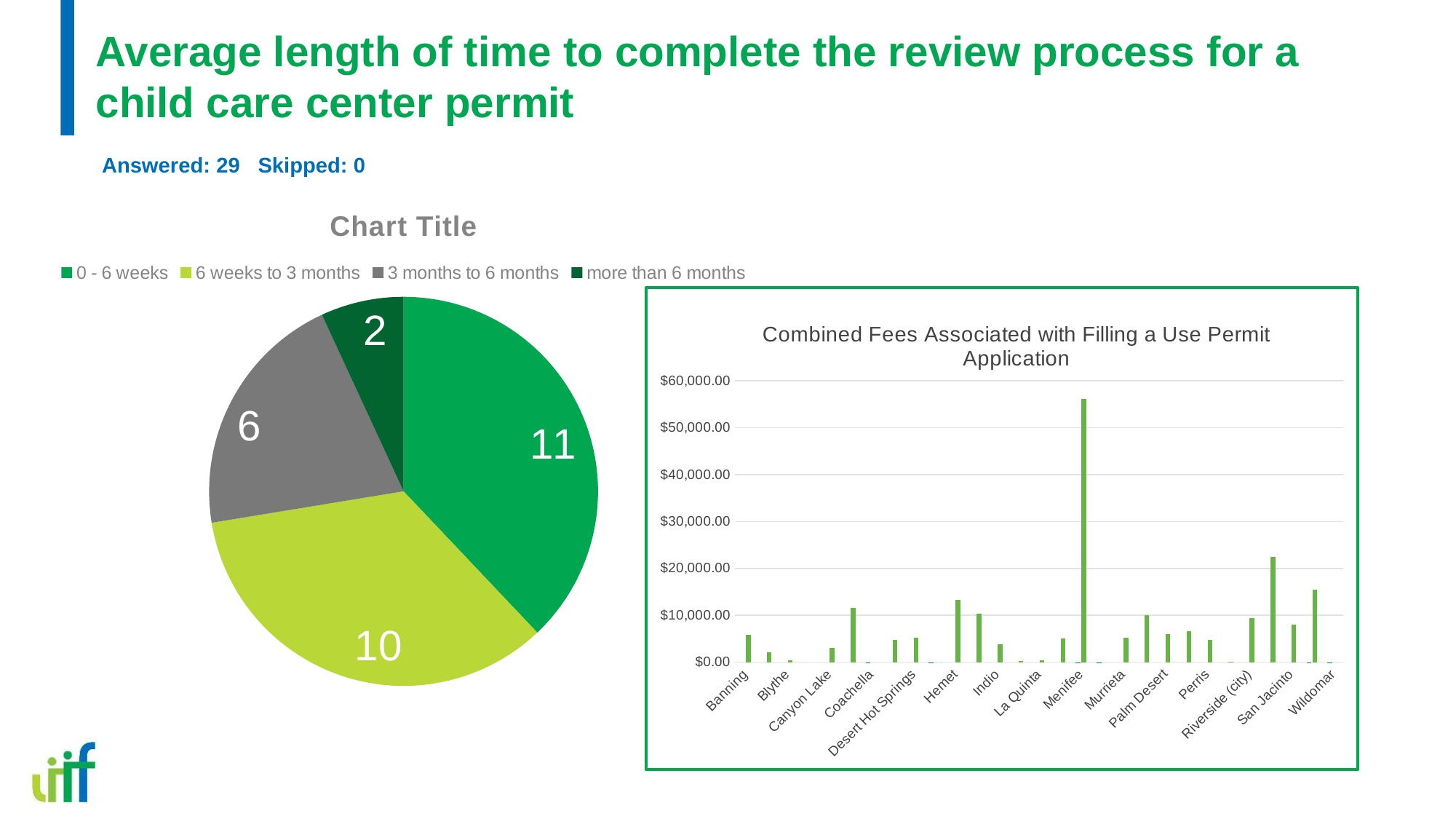
In the pie chart titled 'Chart Title', which category has the smallest slice? more than 6 months In the pie chart titled 'Chart Title', what is the value for 'more than 6 months'? 2 In the pie chart titled 'Chart Title', which is larger: '6 weeks to 3 months' or '3 months to 6 months'? 6 weeks to 3 months In the pie chart titled 'Chart Title', which category has the largest slice? 0 - 6 weeks In the pie chart titled 'Chart Title', what is the total of all four slices? 29 In the pie chart titled 'Chart Title', what is the difference between the '0 - 6 weeks' value and the '3 months to 6 months' value? 5 In the pie chart titled 'Chart Title', what is the value for '6 weeks to 3 months'? 10 How many categories does the legend of the pie chart titled 'Chart Title' list? 4 In the pie chart titled 'Chart Title', how many responses are in the '0 - 6 weeks' category? 11 In the pie chart titled 'Chart Title', what is the value for '3 months to 6 months'? 6 In the chart titled 'Combined Fees Associated with Filling a Use Permit Application', is the tallest bar greater or less than $50,000.00? greater What type of chart is the chart titled 'Combined Fees Associated with Filling a Use Permit Application'? Bar chart